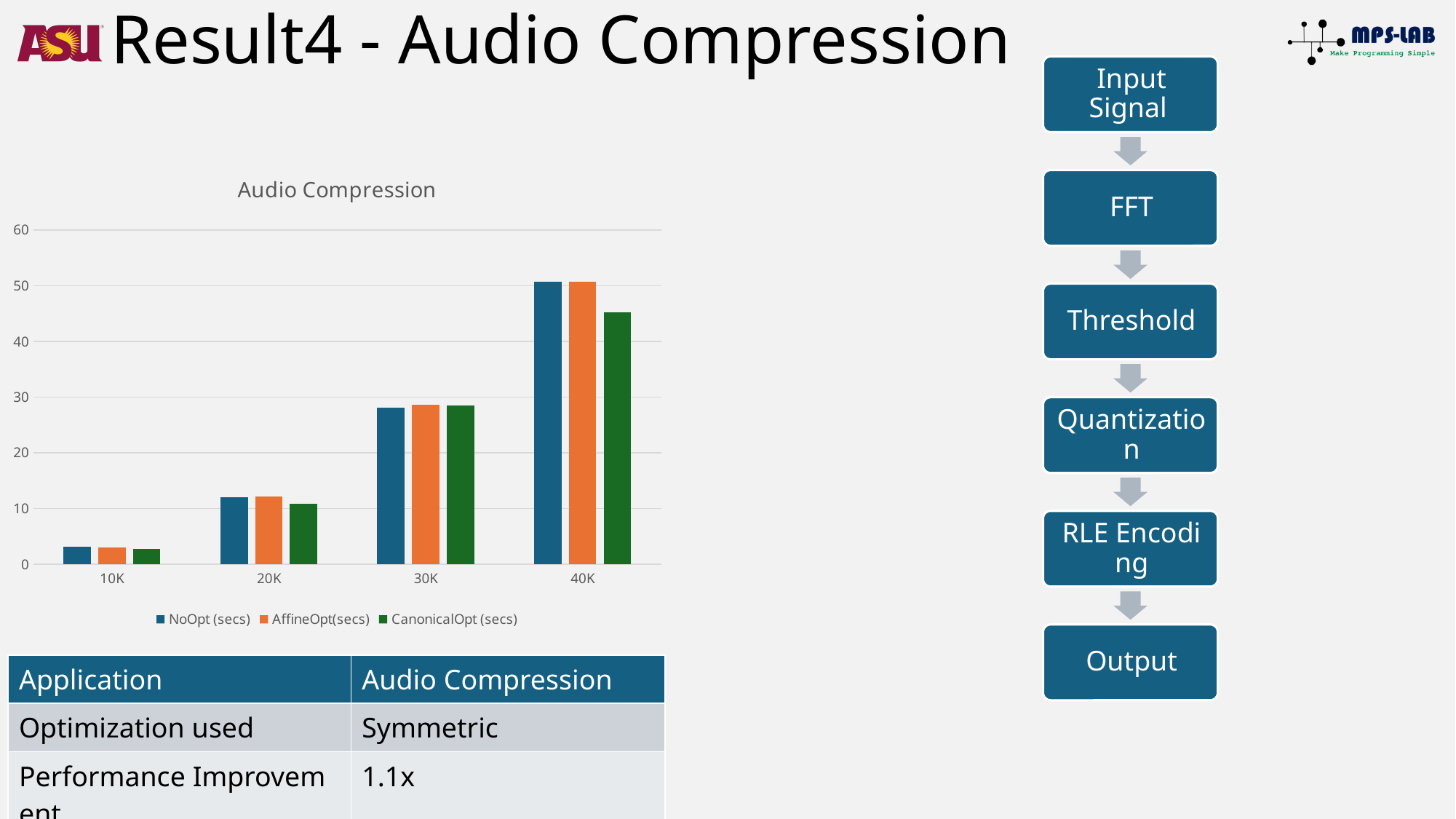
How many series does the legend of the Audio Compression chart list? 3 At 40K, which is larger: the NoOpt (secs) value or the CanonicalOpt (secs) value? NoOpt (secs) What is the title of the chart on the slide? Audio Compression Is the AffineOpt(secs) value for 30K greater or less than 30? less Is the NoOpt (secs) value for 20K greater or less than 10? greater Is the CanonicalOpt (secs) value for 40K greater or less than 50? less What kind of chart is shown on the slide? bar chart Which category has the highest NoOpt (secs) value? 40K Do the NoOpt (secs) values rise or fall as the x axis goes from 10K to 40K? rise How many categories are shown on the x axis of the Audio Compression chart? 4 Which category has the lowest CanonicalOpt (secs) value? 10K